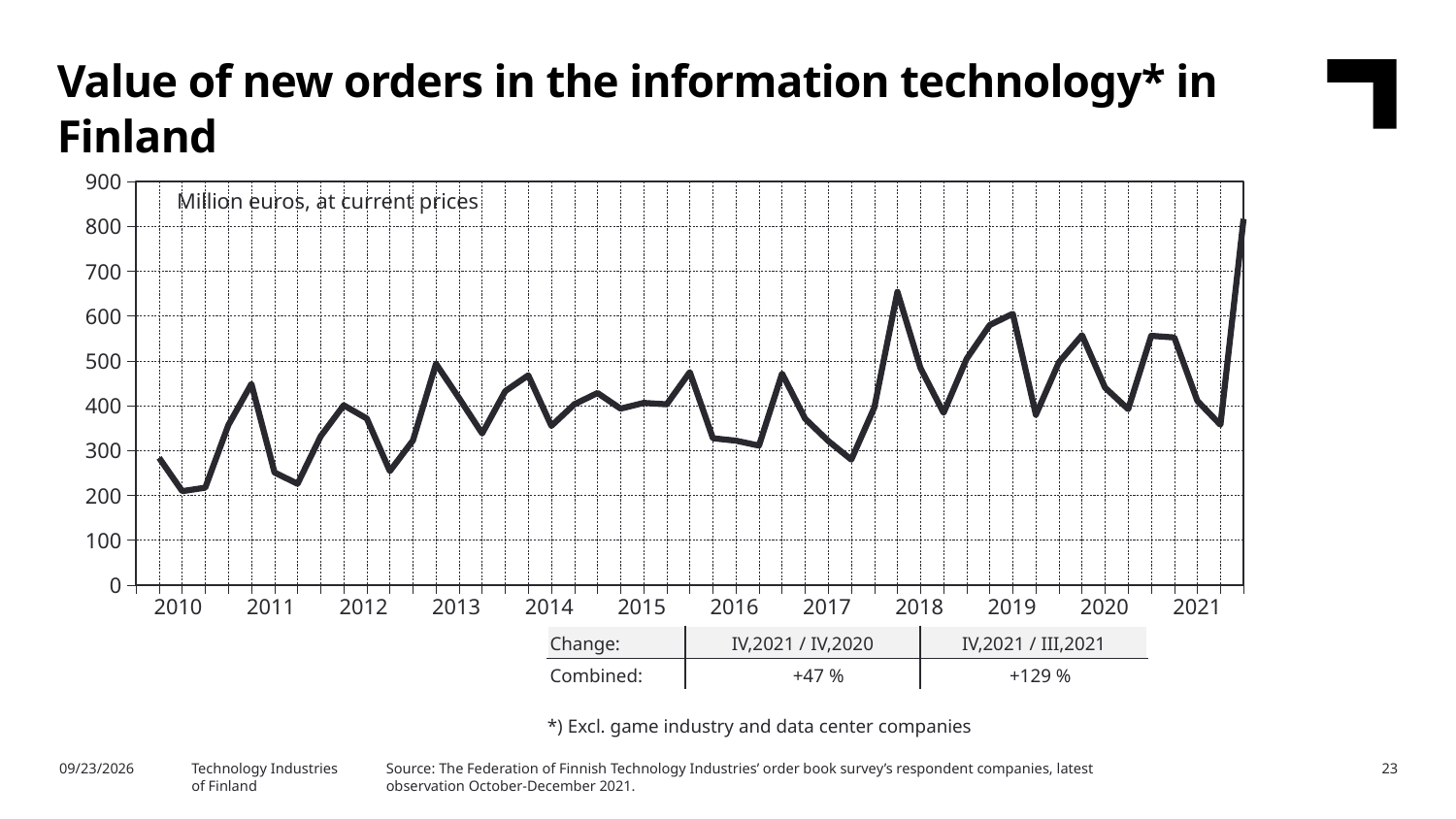
Which is larger: the value at the end of 2021 or the peak value in 2017? the value at the end of 2021 What kind of chart is shown on the slide? line chart What is the change in the value of new orders for IV,2021 / IV,2020 shown in the table below the chart? +47 % What unit is the chart measured in, according to the label inside the plot area? Million euros, at current prices In which year does the line reach its highest value? 2021 What is the change in the value of new orders for IV,2021 / III,2021 shown in the table below the chart? +129 % Is the lowest value in 2010 greater or less than 300? less How many years are labelled on the x axis of the chart? 12 What is the highest value shown on the y axis of the chart? 900 Overall, does the value of new orders rise or fall from the start of 2010 to the end of 2021? rise Is the value at the last point of the line (end of 2021) greater or less than 700? greater